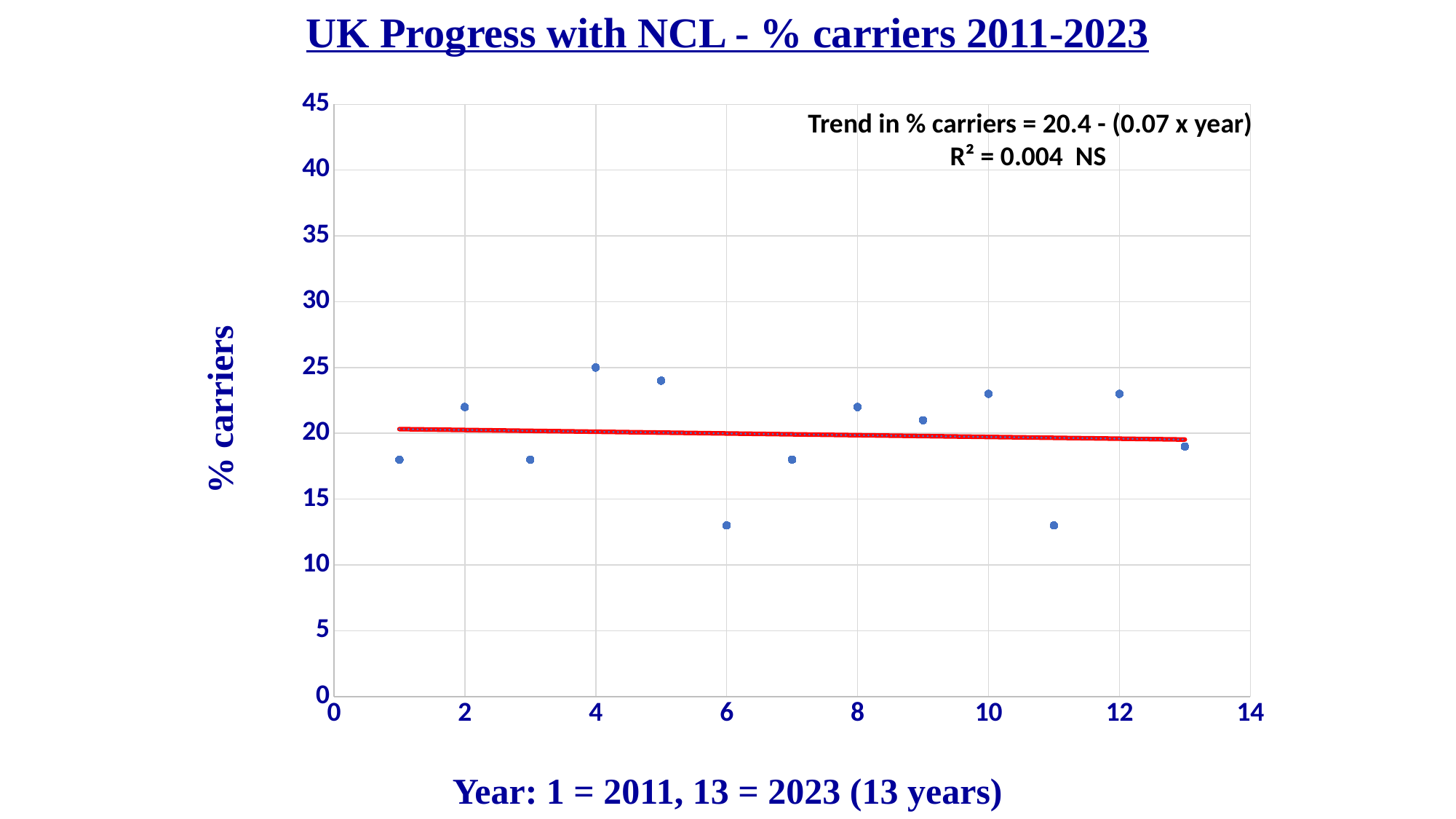
Is the value for year 11 greater or less than 15? less What kind of chart is shown on the slide? scatter chart Which has a higher % carriers value, year 11 or year 12? year 12 Is the value for year 10 greater or less than 20? greater Which has a higher % carriers value, year 4 or year 6? year 4 Is the value for year 6 greater or less than 15? less How many data points are plotted on the chart? 13 According to the trend line, do % carriers rise or fall across the years? fall What is the title of the chart? UK Progress with NCL - % carriers 2011-2023 What is the R² value shown on the chart? 0.004